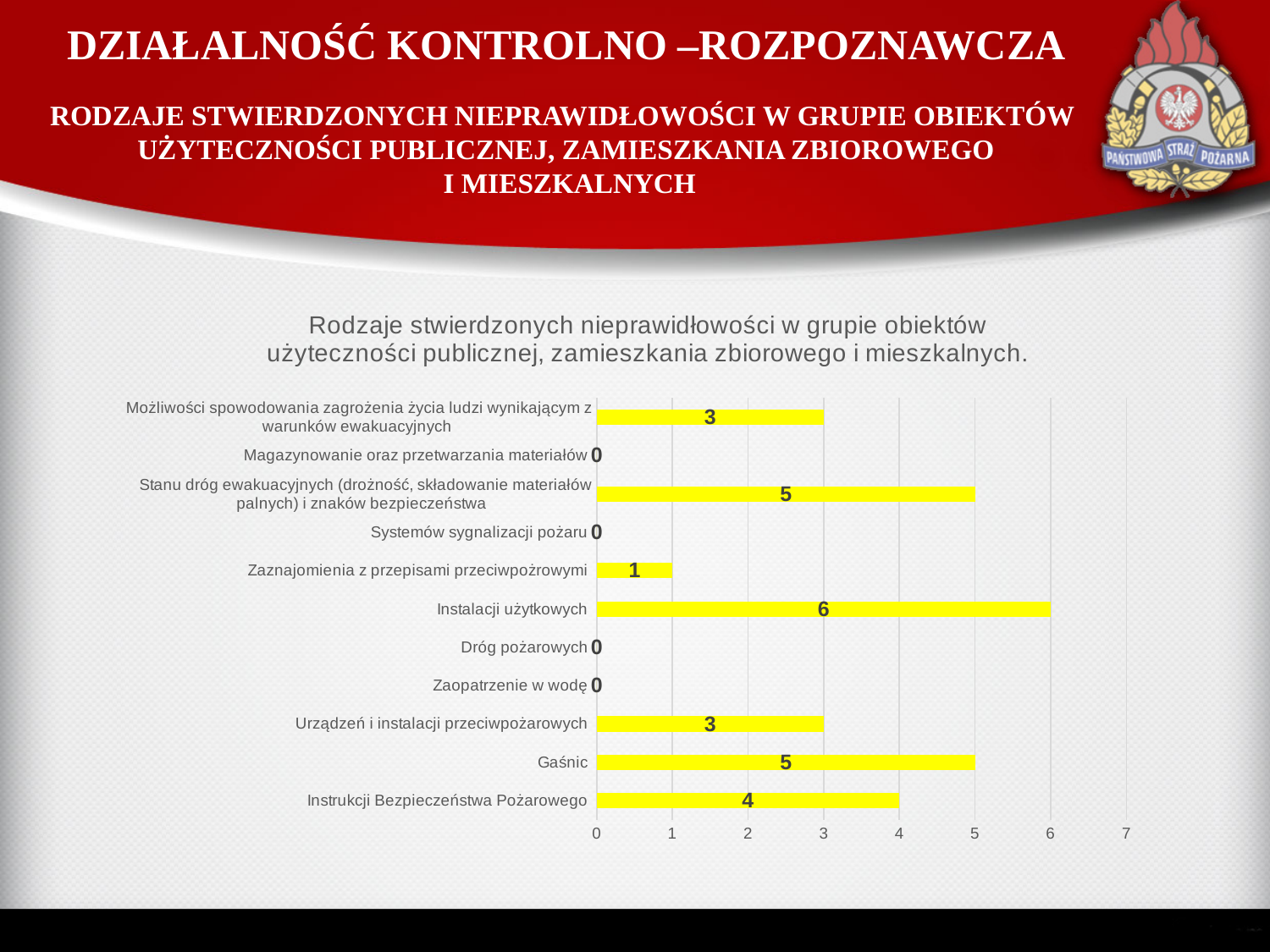
What is the value for Instalacji użytkowych? 6 What colour are the bars in the chart? Yellow How many categories are shown on the chart? 11 Which category has the highest value? Instalacji użytkowych What is the value for Instrukcji Bezpieczeństwa Pożarowego? 4 What is the difference between the values for Instalacji użytkowych and Instrukcji Bezpieczeństwa Pożarowego? 2 Which is larger, the value for Gaśnic or the value for Urządzeń i instalacji przeciwpożarowych? Gaśnic What is the value for Zaznajomienia z przepisami przeciwpożrowymi? 1 What kind of chart is shown on the slide? Bar chart What is the value for Systemów sygnalizacji pożaru? 0 What is the value for Gaśnic? 5 How many categories have a value of 0? 4